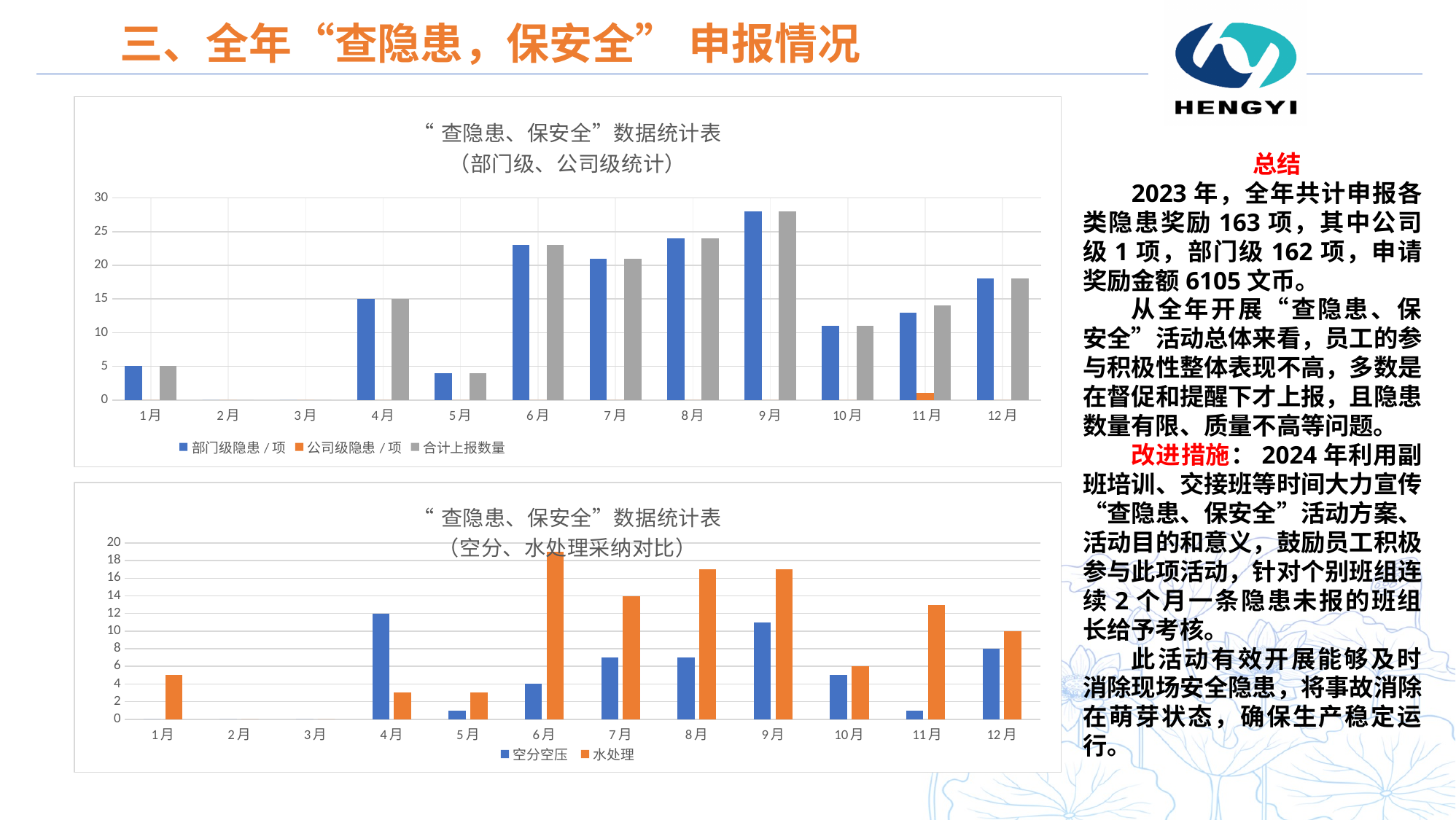
How many series does the legend of the bottom chart (空分、水处理采纳对比) list? 2 In the bottom chart (空分、水处理采纳对比), is the value of 水处理 for 6月 greater or less than 16? greater In the top chart (部门级、公司级统计), in which month does the 公司级隐患/项 series show a non-zero bar? 11月 What type of chart is the top chart titled “查隐患、保安全”数据统计表（部门级、公司级统计）? bar chart In the top chart (部门级、公司级统计), is the value of 合计上报数量 for 10月 greater or less than 15? less In the bottom chart (空分、水处理采纳对比), is the value of 空分空压 for 11月 greater or less than 4? less In the top chart (部门级、公司级统计), which month has the highest 合计上报数量? 9月 In the bottom chart (空分、水处理采纳对比), which is larger for 4月: 空分空压 or 水处理? 空分空压 How many series does the legend of the top chart (部门级、公司级统计) list? 3 How many months are shown on the x axis of the bottom chart (空分、水处理采纳对比)? 12 In the top chart (部门级、公司级统计), which is larger: 部门级隐患/项 for 8月 or for 7月? 8月